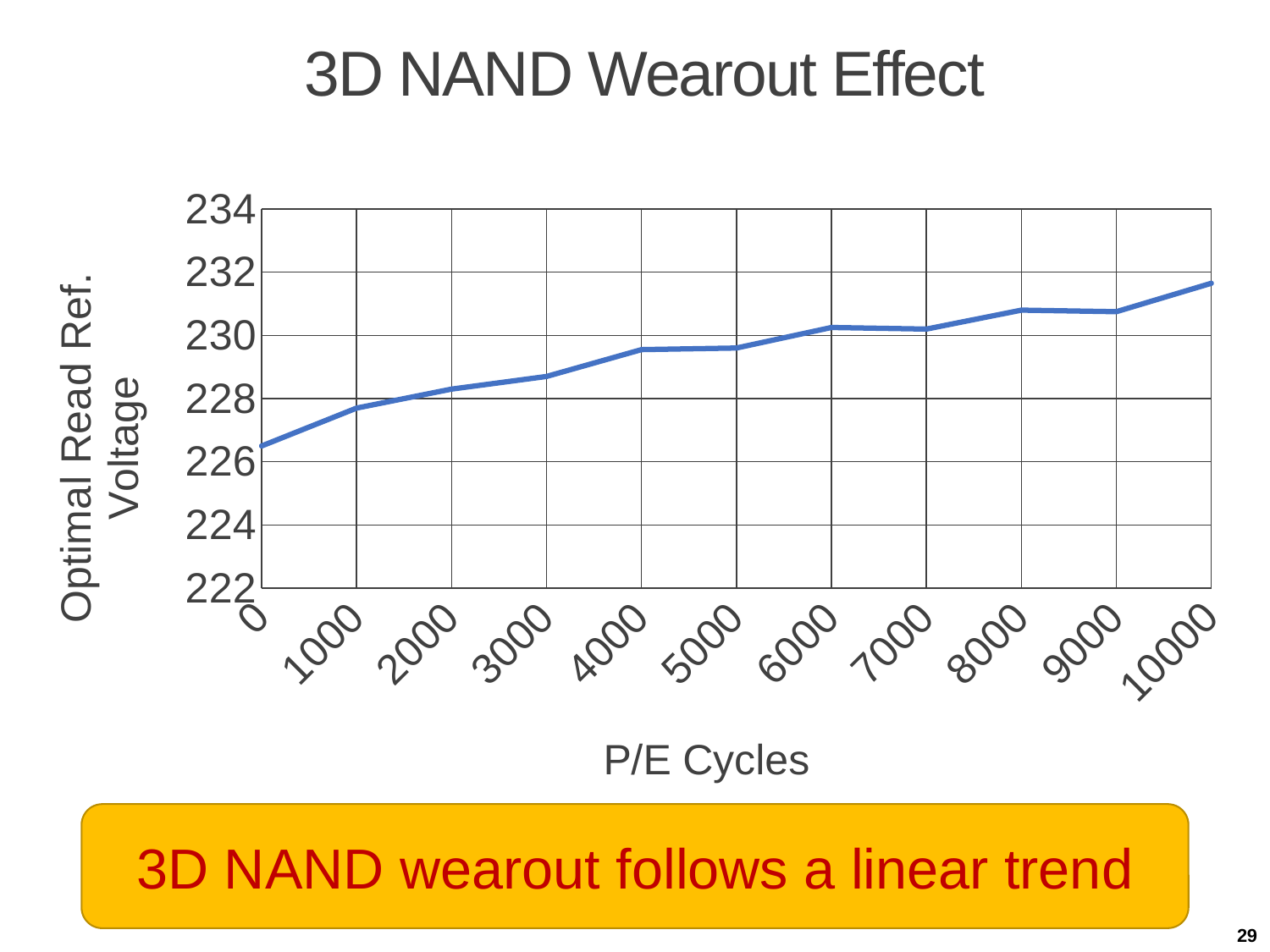
What kind of chart is shown on the slide? line chart Is the value for 8000 P/E cycles greater or less than 232? less At which P/E cycle count is the optimal read reference voltage highest? 10000 Is the value for 4000 P/E cycles greater or less than 228? greater Does the optimal read reference voltage rise or fall as P/E cycles increase? rise Which has the larger optimal read reference voltage, 1000 P/E cycles or 9000 P/E cycles? 9000 Is the value for 10000 P/E cycles greater or less than 230? greater At which P/E cycle count is the optimal read reference voltage lowest? 0 What is the title of the chart? 3D NAND Wearout Effect What is the label of the x axis? P/E Cycles